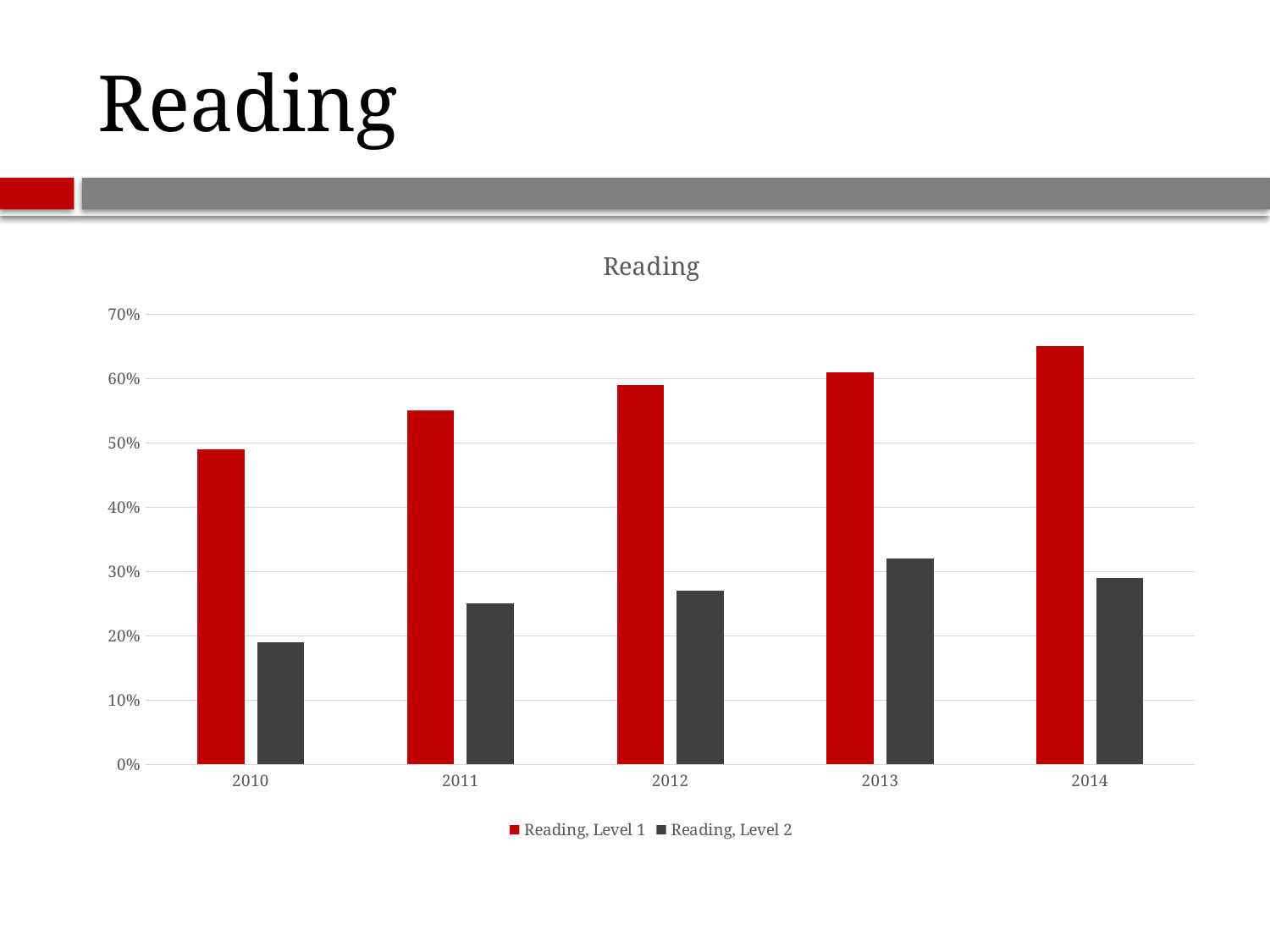
Does the Reading, Level 1 value rise or fall from 2010 to 2014? Rise In which year is the Reading, Level 2 value highest? 2013 In which year is the Reading, Level 2 value lowest? 2010 What kind of chart is shown on the slide? Bar chart Which is larger in 2013: Reading, Level 1 or Reading, Level 2? Reading, Level 1 Is the Reading, Level 1 value for 2014 greater or less than 60%? greater How many series does the legend list? 2 Is the Reading, Level 2 value for 2012 greater or less than 30%? less In which year is the Reading, Level 1 value highest? 2014 How many years are shown on the x axis? 5 What colour are the Reading, Level 1 bars? Red In which year is the Reading, Level 1 value lowest? 2010